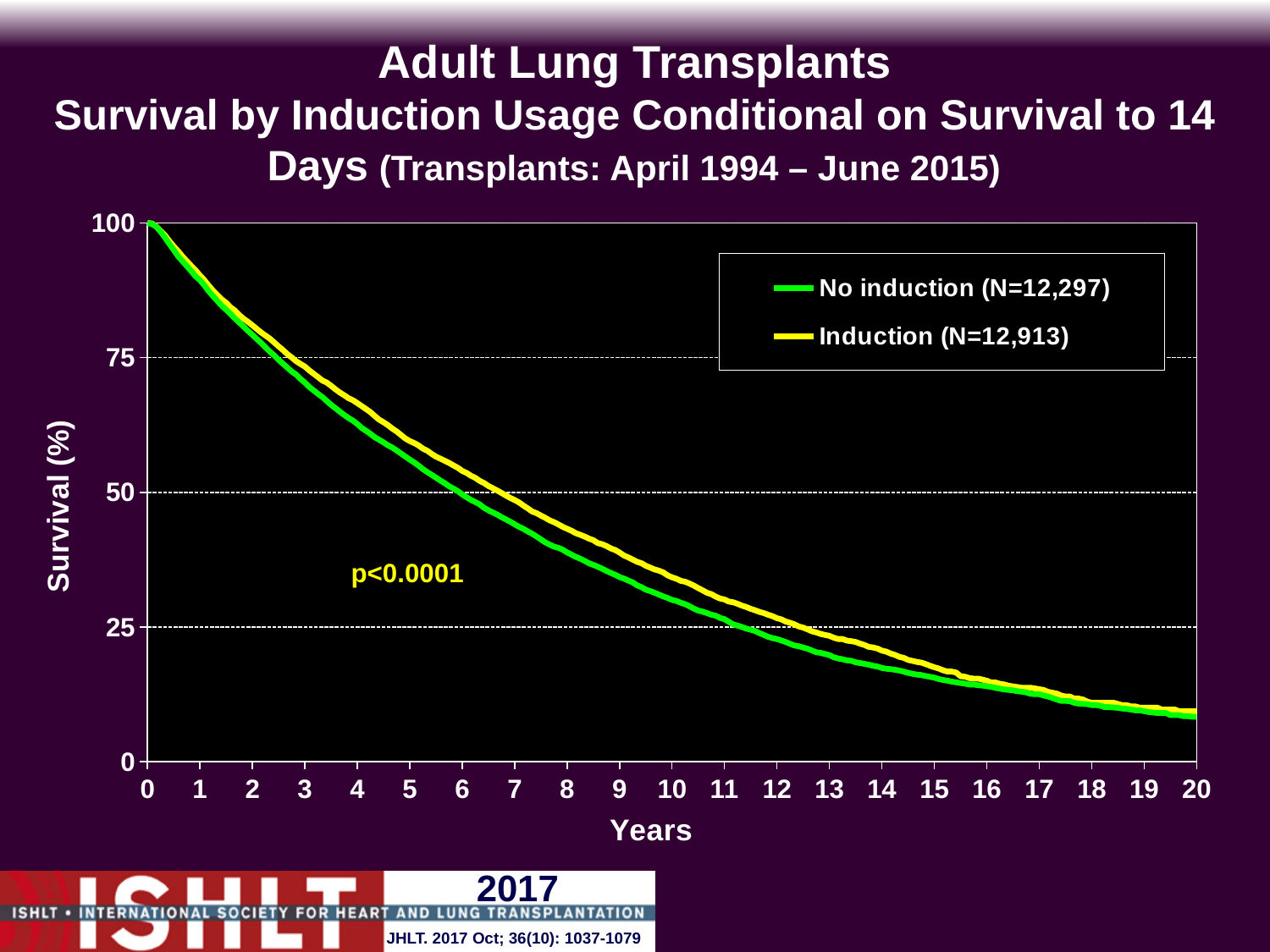
Is the survival value for No induction at year 10 greater or less than 50? less What p-value is printed on the chart? p<0.0001 What is the survival value for both curves at year 0? 100 At year 5, which curve is higher: Induction or No induction? Induction Is the survival value for Induction at year 15 greater or less than 25? less At year 8, which curve is higher: Induction or No induction? Induction Do the survival curves rise or fall as years increase? Fall How many series does the legend list? 2 Is the survival value for No induction at year 1 greater or less than 75? greater What is the N value shown in the legend for the Induction group? N=12,913 What kind of chart is shown on the slide? Line chart